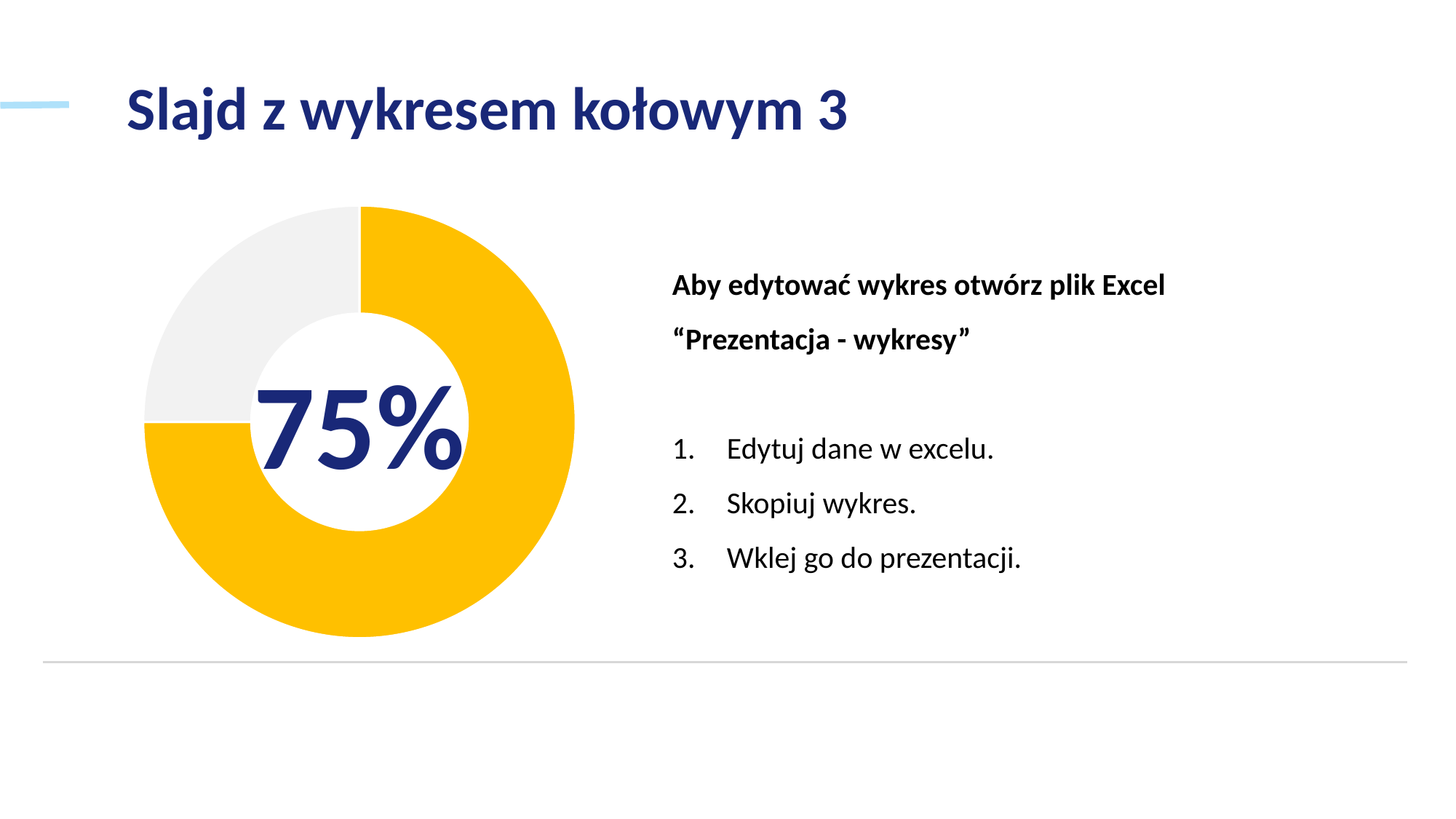
What colour is the largest slice of the donut chart? Yellow What percentage is printed in the centre of the donut chart? 75% What share of the donut chart does the yellow slice represent? 75% Which slice of the donut chart is larger, the yellow one or the grey one? The yellow one What kind of chart is shown on the slide? Pie chart (donut) How many slices does the donut chart have? 2 What is the title of the slide containing the donut chart? Slajd z wykresem kołowym 3